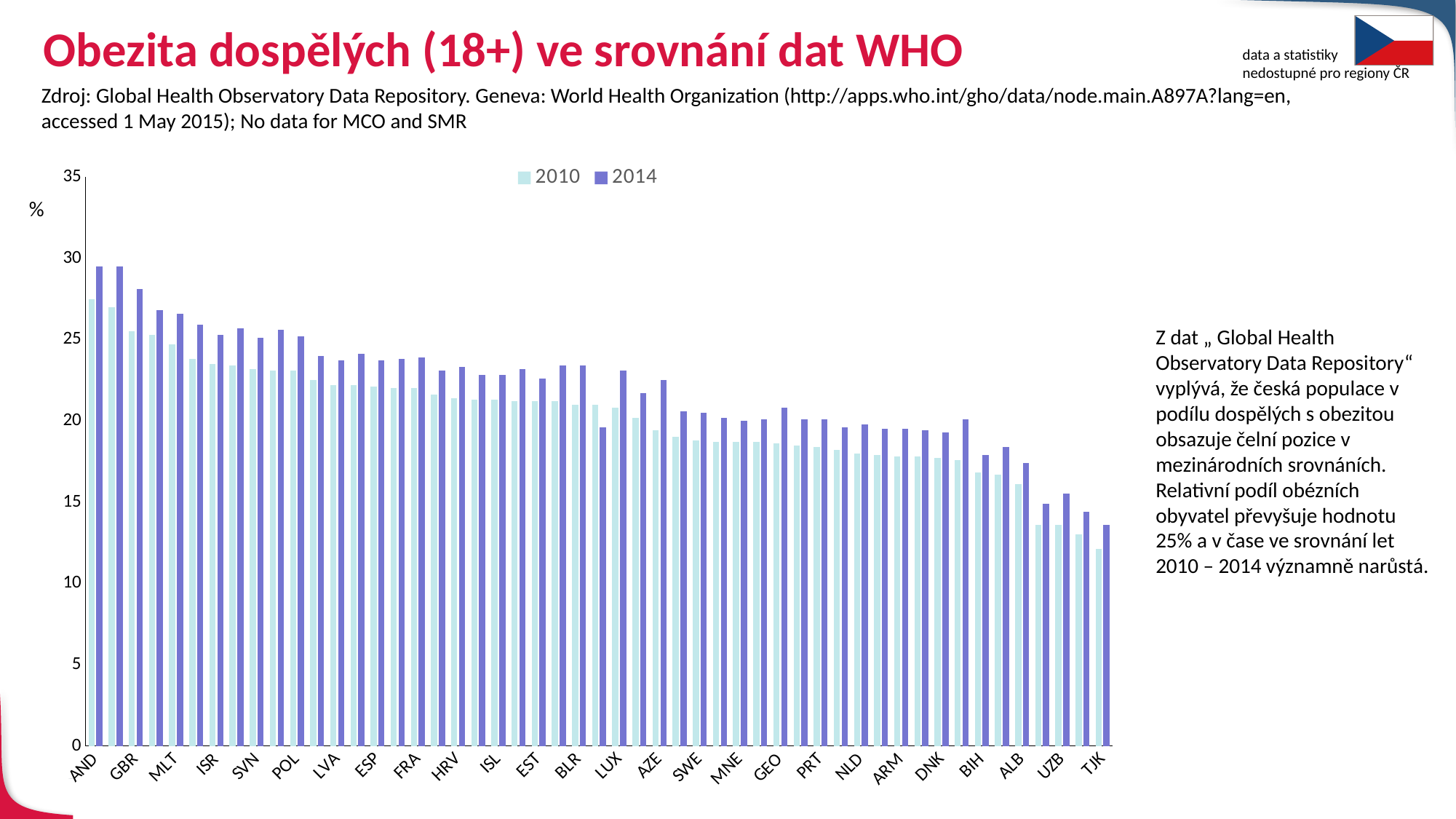
Is the 2014 value for AND greater or less than 25? greater Is the 2014 value for TJK greater or less than 15? less Which two years are listed in the chart legend? 2010 and 2014 Which of the labelled countries has the lowest 2014 value? TJK What unit is shown on the vertical axis of the chart? % Do the 2014 values generally rise or fall moving from left to right along the x axis? fall How many series does the legend list? 2 Which is larger, the 2014 value for AND or the 2014 value for TJK? AND Is the 2014 value for BIH greater or less than 20? less What kind of chart is shown on the slide? bar chart